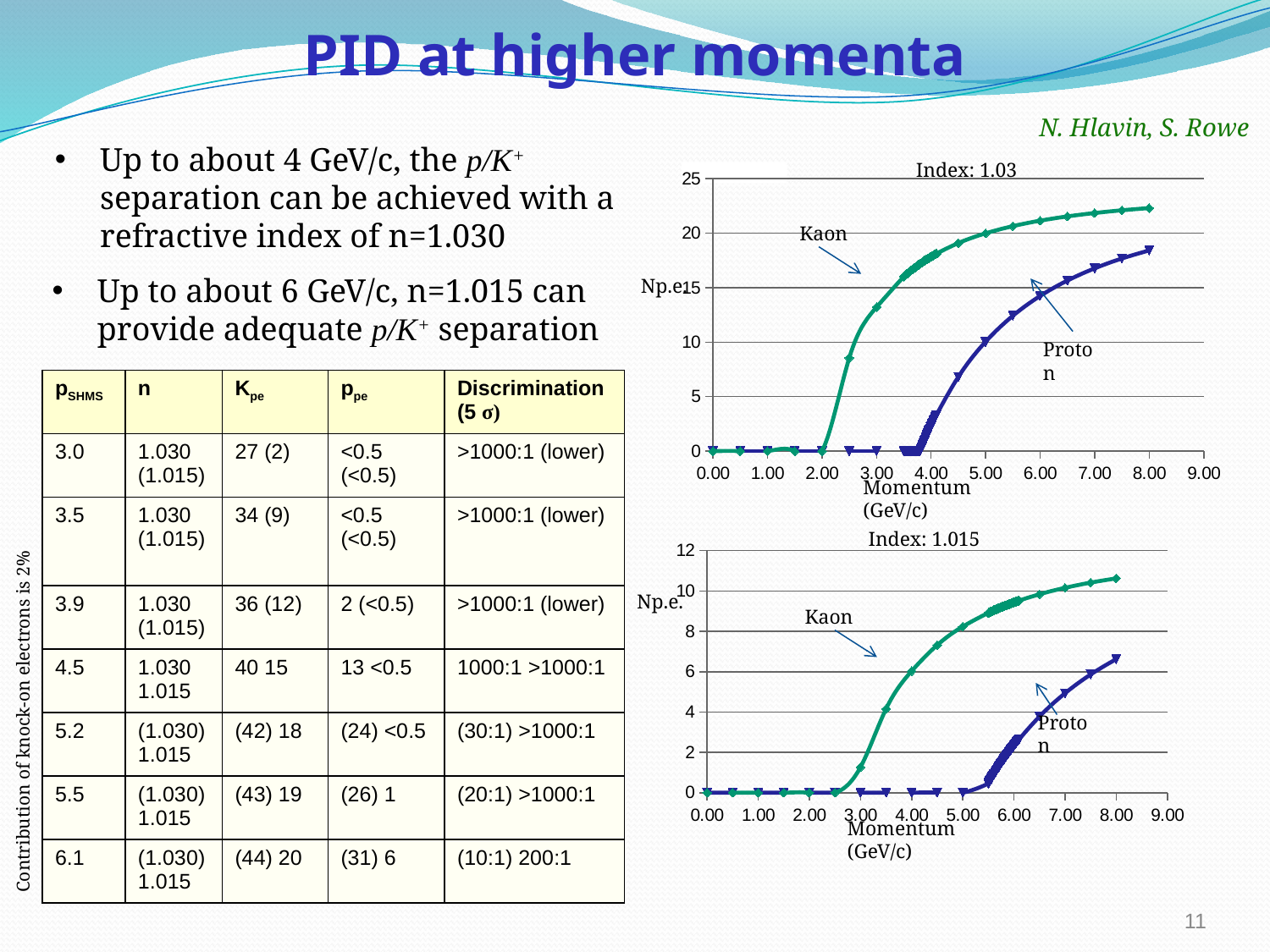
In the top chart (Index: 1.03), is the Kaon value at 8.00 GeV/c greater or less than 20? greater What kind of chart is the top chart titled "Index: 1.03"? line chart In the bottom chart (Index: 1.015), does the Kaon series rise or fall as momentum increases from 3.00 to 8.00 GeV/c? rise In the bottom chart (Index: 1.015), is the Kaon value at 8.00 GeV/c greater or less than 10? greater How many series are plotted in the bottom chart titled "Index: 1.015"? 2 What is the x-axis label of the bottom chart (Index: 1.015)? Momentum (GeV/c) In the top chart (Index: 1.03), is the Proton value at 8.00 GeV/c greater or less than 20? less In the top chart (Index: 1.03), at 6.00 GeV/c, which series has the larger value, Kaon or Proton? Kaon In the top chart (Index: 1.03), which two particle series are labelled? Kaon and Proton In the bottom chart (Index: 1.015), at 7.00 GeV/c, which series has the larger value, Kaon or Proton? Kaon